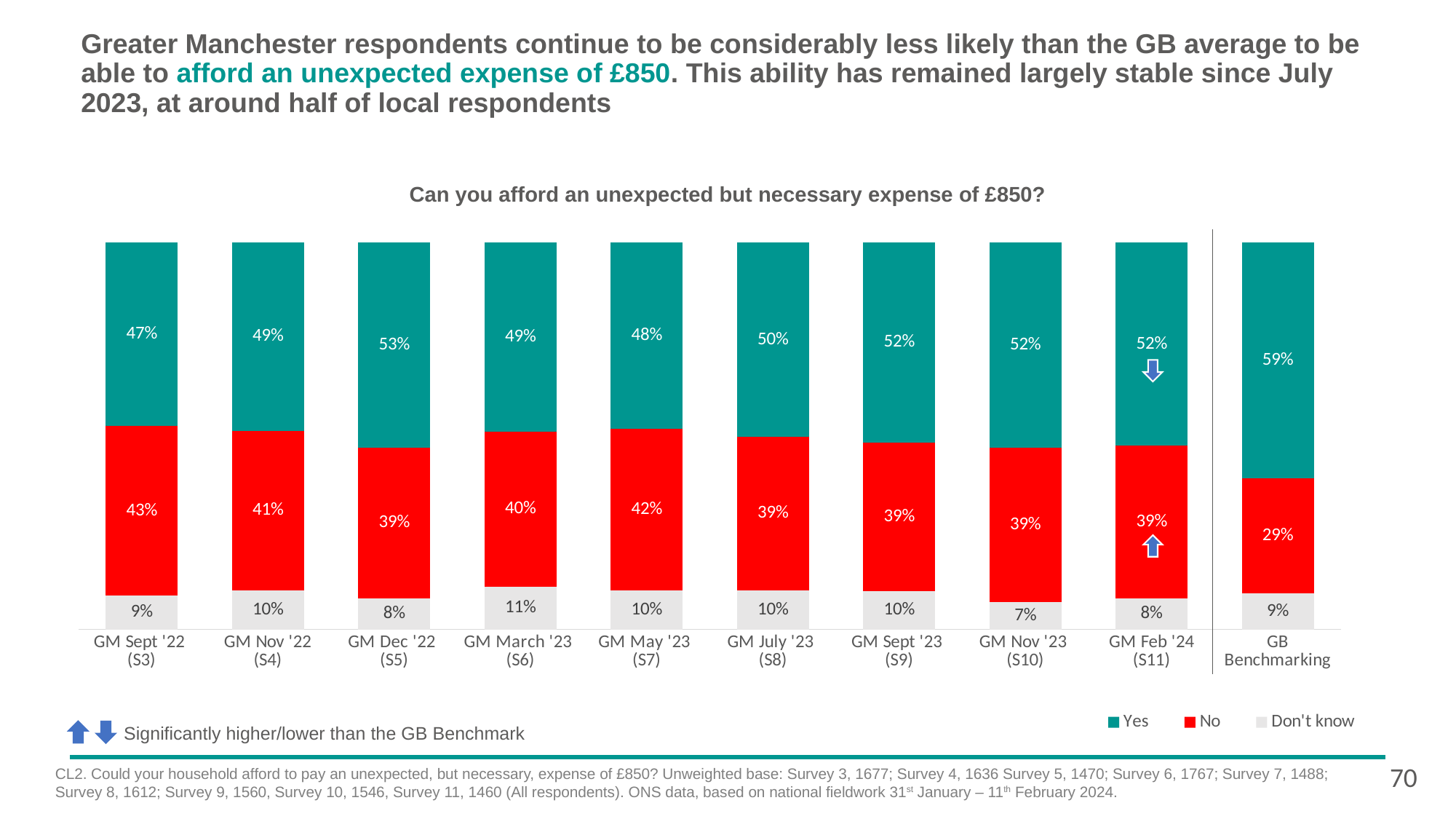
How many categories are shown on the x axis? 10 What kind of chart is shown on the slide? Stacked bar chart How many series does the legend list? 3 Which is larger: the No value for GM May '23 (S7) or the No value for GM July '23 (S8)? GM May '23 (S7) What is the title of the chart? Can you afford an unexpected but necessary expense of £850? Which category has the lowest Don't know value? GM Nov '23 (S10) What is the difference between the Yes value for GB Benchmarking and the Yes value for GM Feb '24 (S11)? 7 percentage points What is the No value for GB Benchmarking? 29% Which category has the highest No value? GM Sept '22 (S3) What is the Don't know value for GM March '23 (S6)? 11% What percentage of GM Feb '24 (S11) respondents answered Yes? 52% Which category has the highest Yes value? GB Benchmarking